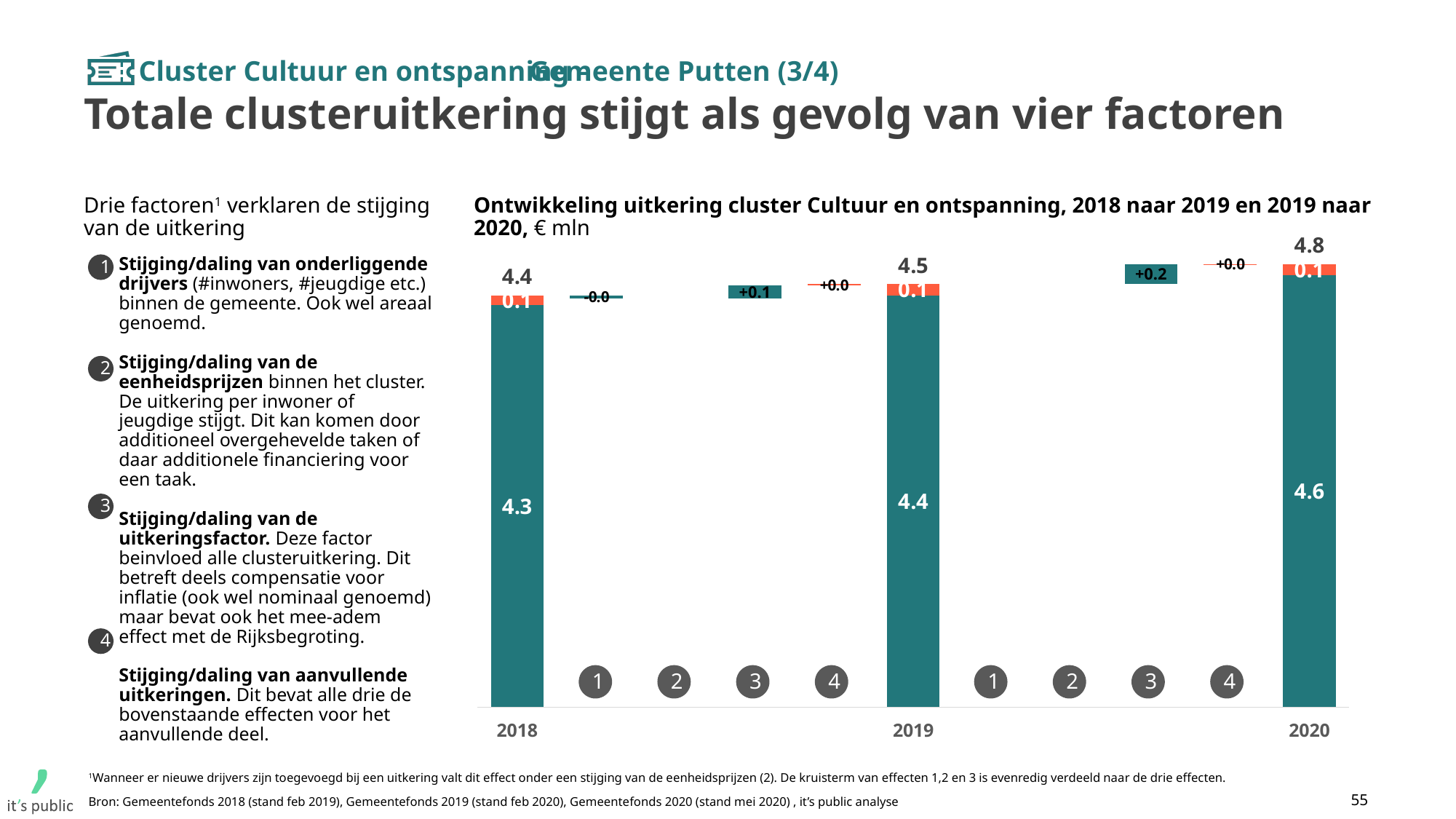
Do the total values rise or fall from 2018 to 2020? rise What is the total uitkering for 2018 shown above the bar? 4.4 What is the effect of factor 3 between 2018 and 2019? +0.1 What is the value of the large teal segment of the 2018 bar? 4.3 What is the total uitkering for 2020 shown above the bar? 4.8 What is the total uitkering for 2019 shown above the bar? 4.5 What is the effect of factor 3 between 2019 and 2020? +0.2 What is the difference between the 2020 total and the 2018 total? 0.4 Which year has the lowest total uitkering? 2018 What is the value of the large teal segment of the 2020 bar? 4.6 In what unit are the values in the chart expressed? € mln Which year has the highest total uitkering? 2020